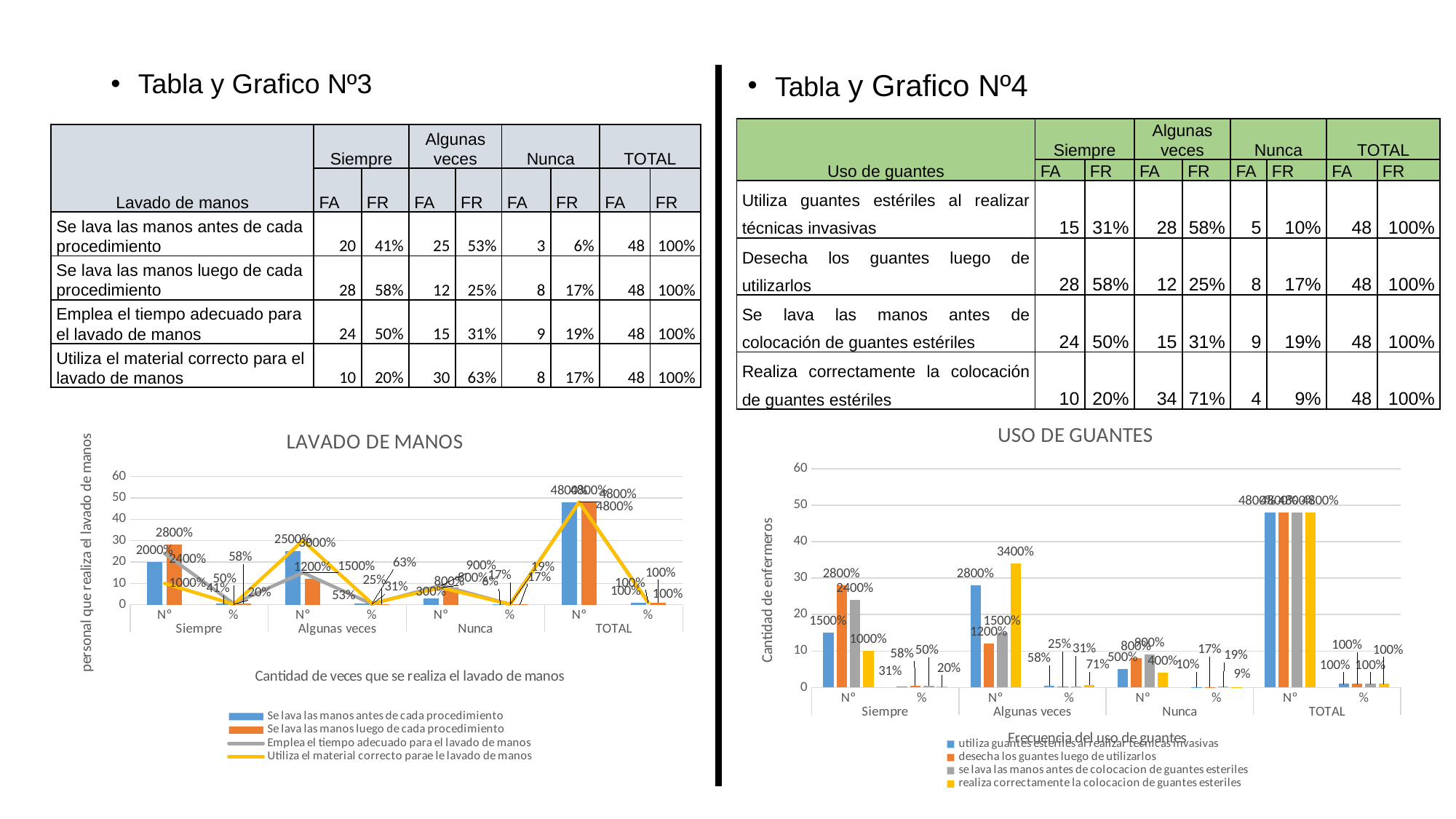
What is the title of the chart on the right side of the slide? USO DE GUANTES In the LAVADO DE MANOS chart, at N° under Algunas veces, which bar is taller: the blue bar (Se lava las manos antes de cada procedimiento) or the orange bar (Se lava las manos luego de cada procedimiento)? the blue bar (Se lava las manos antes de cada procedimiento) In the USO DE GUANTES chart, which series has the tallest bar at N° under Algunas veces? realiza correctamente la colocacion de guantes esteriles What is the title of the chart on the left side of the slide? LAVADO DE MANOS In the LAVADO DE MANOS chart, what data label is shown on the orange bar (Se lava las manos luego de cada procedimiento) at N° under Siempre? 2800% In the USO DE GUANTES chart, is the blue bar (utiliza guantes esteriles al realizar tecnicas invasivas) at N° under Siempre greater or less than 20? less In the LAVADO DE MANOS chart, how many series does the legend list? 4 In the USO DE GUANTES chart, what data label is shown on the yellow bar (realiza correctamente la colocacion de guantes esteriles) at N° under Algunas veces? 3400% In the USO DE GUANTES chart, how many series does the legend list? 4 In the USO DE GUANTES chart, how many main category groups are shown along the x axis? 4 What kind of chart is the USO DE GUANTES chart? bar chart In the USO DE GUANTES chart, which series has the tallest bar at N° under Siempre? desecha los guantes luego de utilizarlos